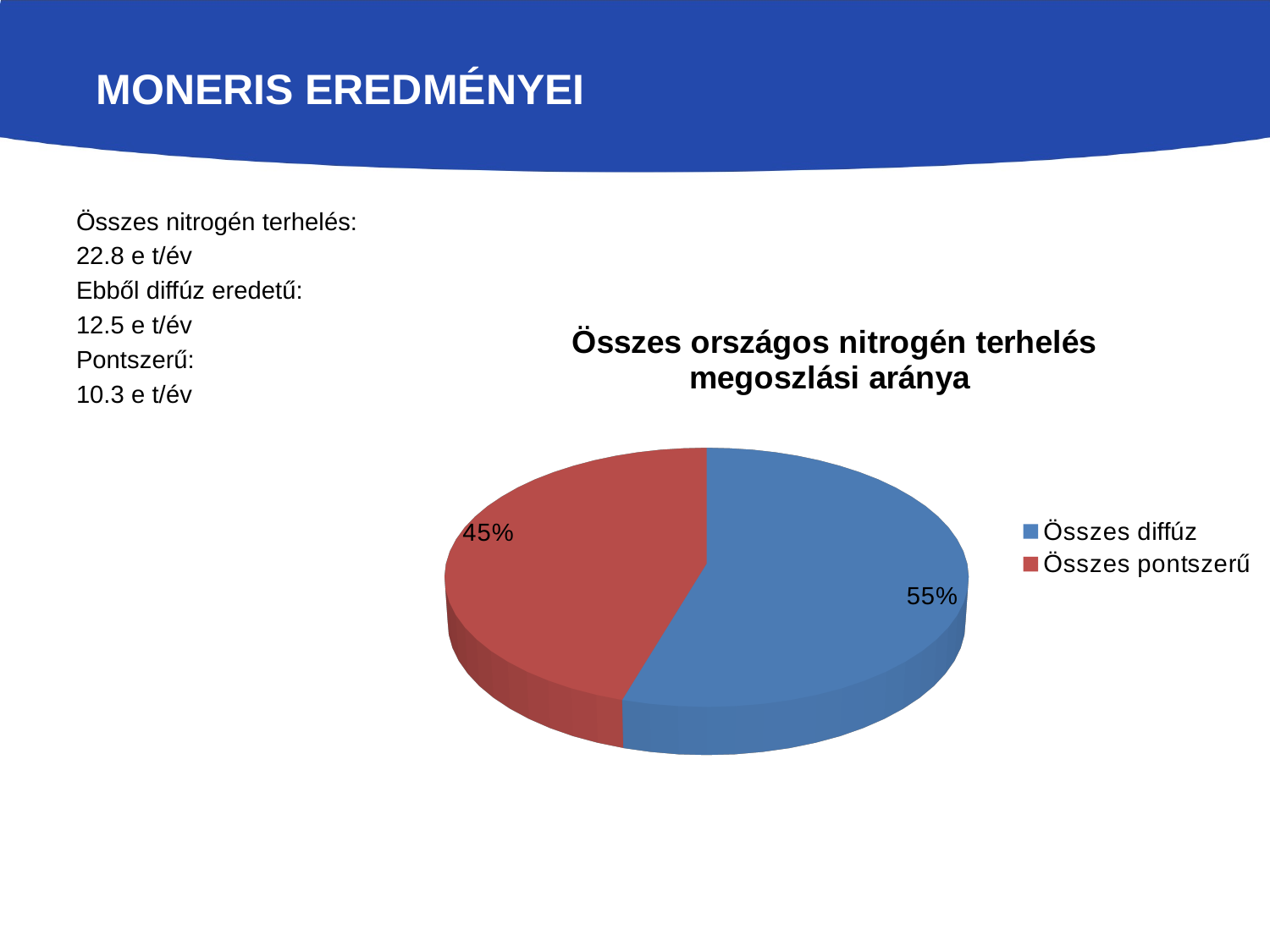
What share of the pie does Összes pontszerű represent? 45% Which category has the largest slice of the pie? Összes diffúz What is the title of the chart? Összes országos nitrogén terhelés megoszlási aránya How many slices does the pie chart have? 2 Which is larger, the share for Összes diffúz or the share for Összes pontszerű? Összes diffúz Which colour represents Összes pontszerű in the pie chart? red Is the share for Összes diffúz greater or less than 50%? greater How many entries does the legend list? 2 What share of the pie does Összes diffúz represent? 55% What is the difference in percentage points between the Összes diffúz and Összes pontszerű slices? 10 percentage points What kind of chart is shown on the slide? pie chart Which category has the smallest slice of the pie? Összes pontszerű